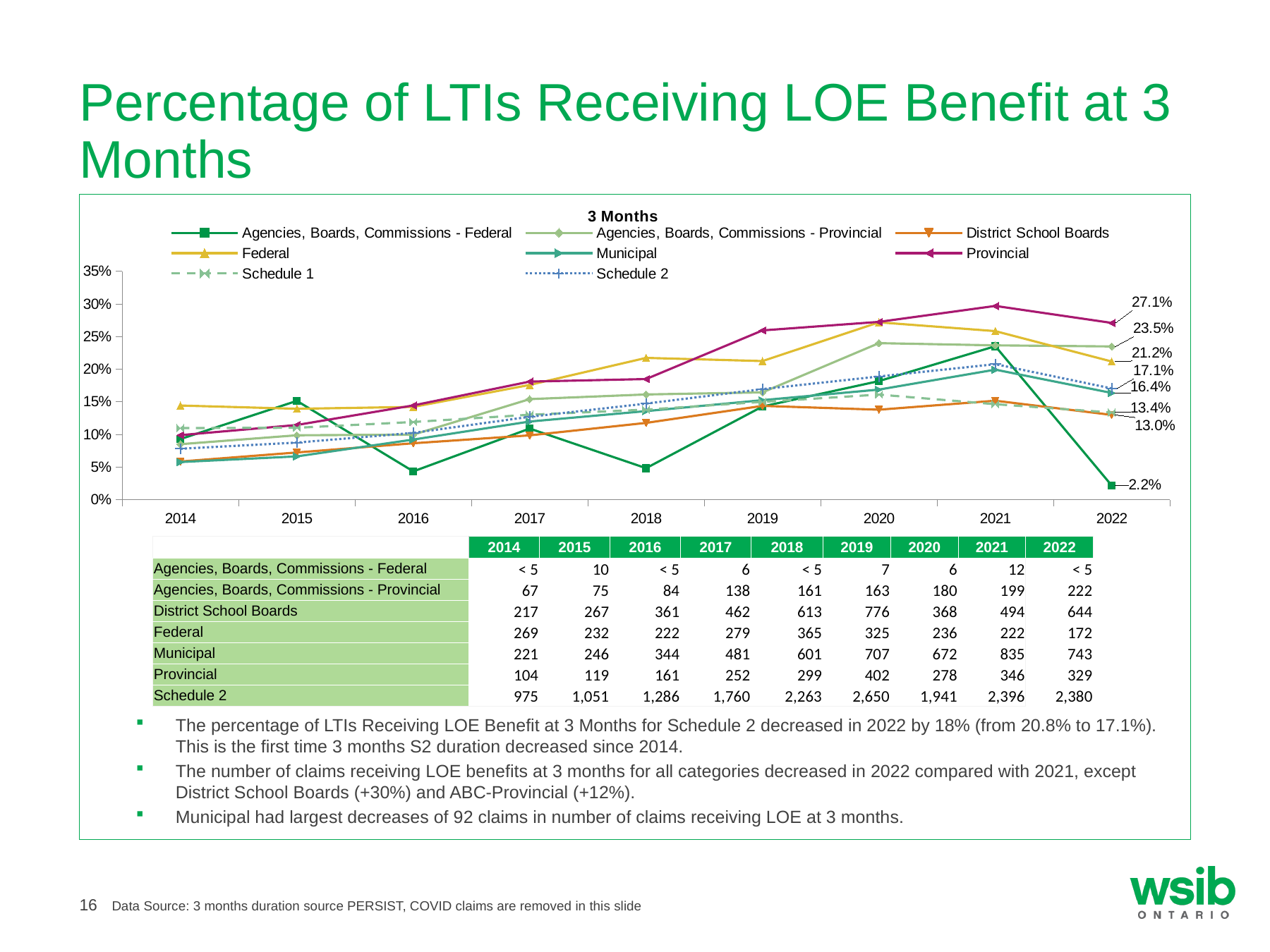
What is the value for Agencies, Boards, Commissions - Federal in 2022? 2.2% Which series has the highest value in 2022? Provincial What kind of chart is shown on the slide? line chart What is the value for Provincial in 2022? 27.1% What is the value for Schedule 2 in 2022? 17.1% What is the difference between the 2022 values for Provincial and Agencies, Boards, Commissions - Federal? 24.9 percentage points How many series does the chart legend list? 8 What is the title shown above the chart legend? 3 Months Which series has the lowest value in 2022? Agencies, Boards, Commissions - Federal Is the value for Provincial in 2014 greater or less than 15%? less How many years are plotted along the x axis of the chart? 9 Is the value for Provincial in 2021 greater or less than 25%? greater